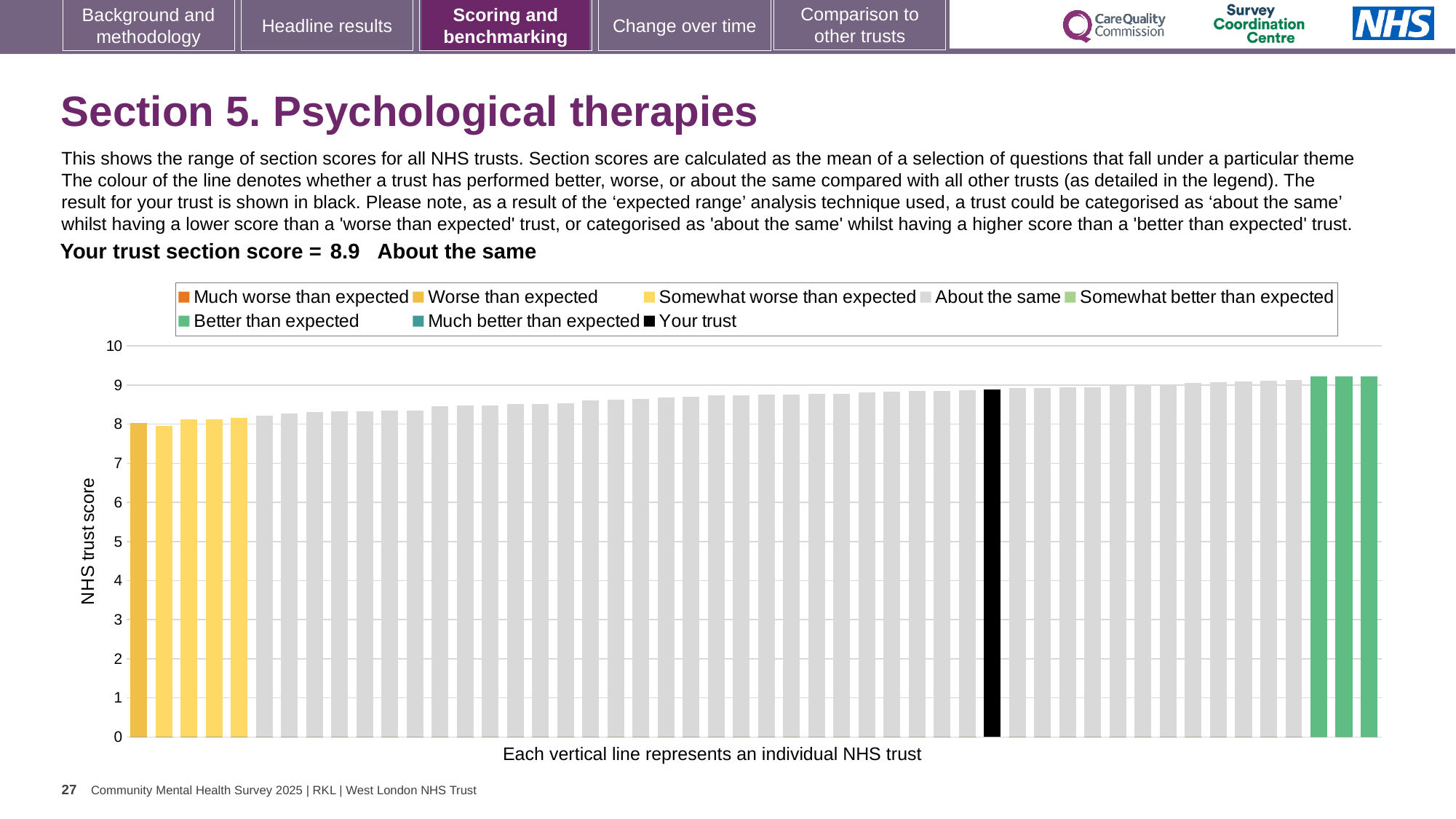
What is the section score for your trust shown on the slide? 8.9 Is the value of the black 'Your trust' bar greater or less than 8? greater How many bars are coloured green ('Better than expected') in the chart? 3 What kind of chart is shown on the slide? Bar chart What colour is the bar representing your trust? Black How many entries does the chart legend list? 8 What is the highest value shown on the vertical axis? 10 Is the value of the rightmost green bar greater or less than 9? greater Which category is your trust's section score placed in? About the same What is the label of the vertical axis? NHS trust score Do the bar values rise or fall from left to right across the chart? Rise Is the value of the leftmost bar greater or less than 9? less